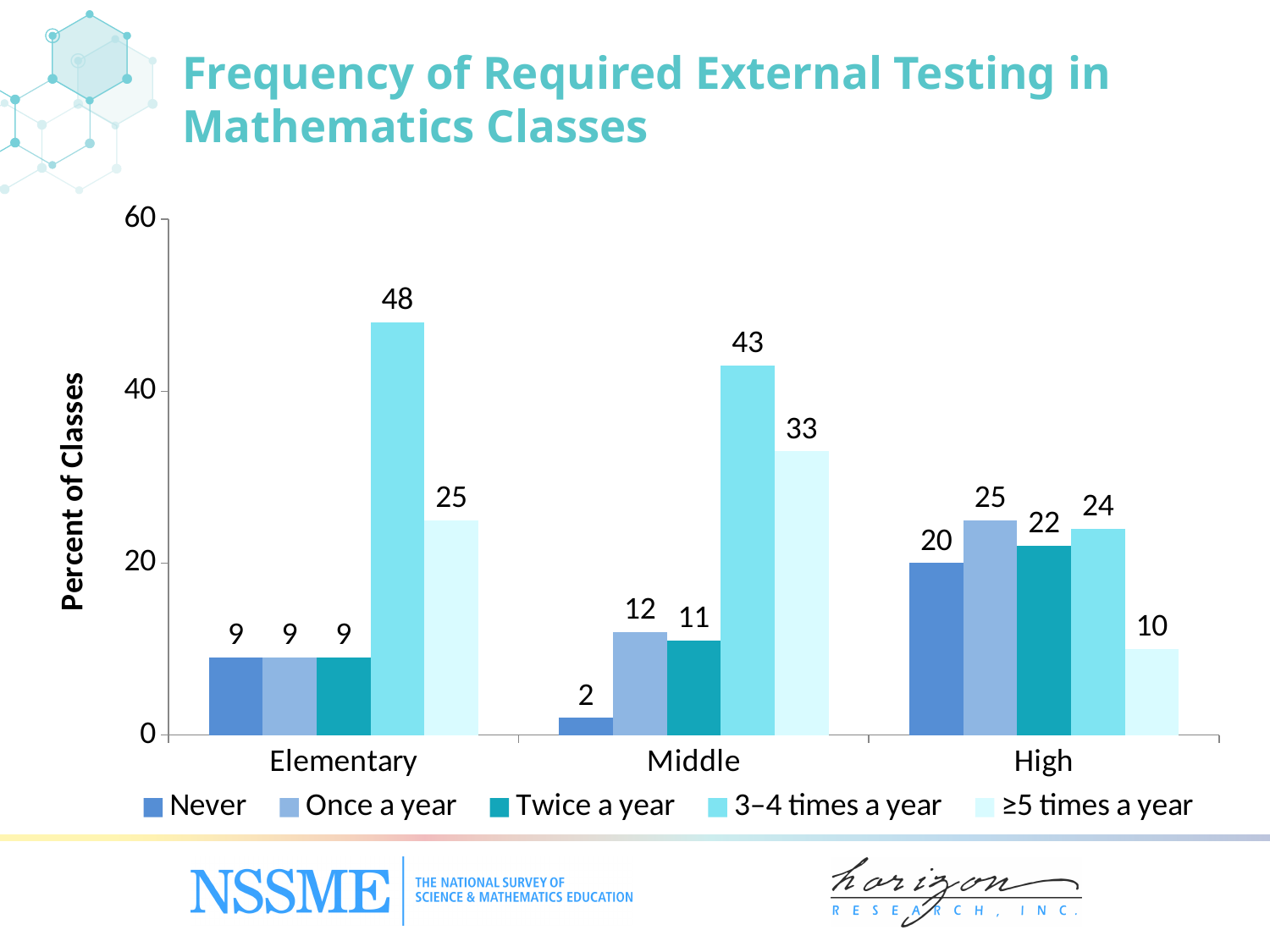
What kind of chart is shown on the slide? Bar chart Which testing frequency has the lowest percent of classes for Middle? Never What percent of Middle school mathematics classes have required external testing ≥5 times a year? 33 What is the difference between the percent of Elementary classes tested 3–4 times a year and the percent tested ≥5 times a year? 23 What percent of Elementary mathematics classes have required external testing 3–4 times a year? 48 What percent of High school mathematics classes have required external testing once a year? 25 Which is larger: the percent of High school classes tested twice a year or the percent tested ≥5 times a year? Twice a year Which testing frequency has the highest percent of classes for Elementary? 3–4 times a year What percent of Middle school mathematics classes never have required external testing? 2 What is the label of the y axis? Percent of Classes How many series does the legend list? 5 How many grade-level categories are shown on the x axis? 3